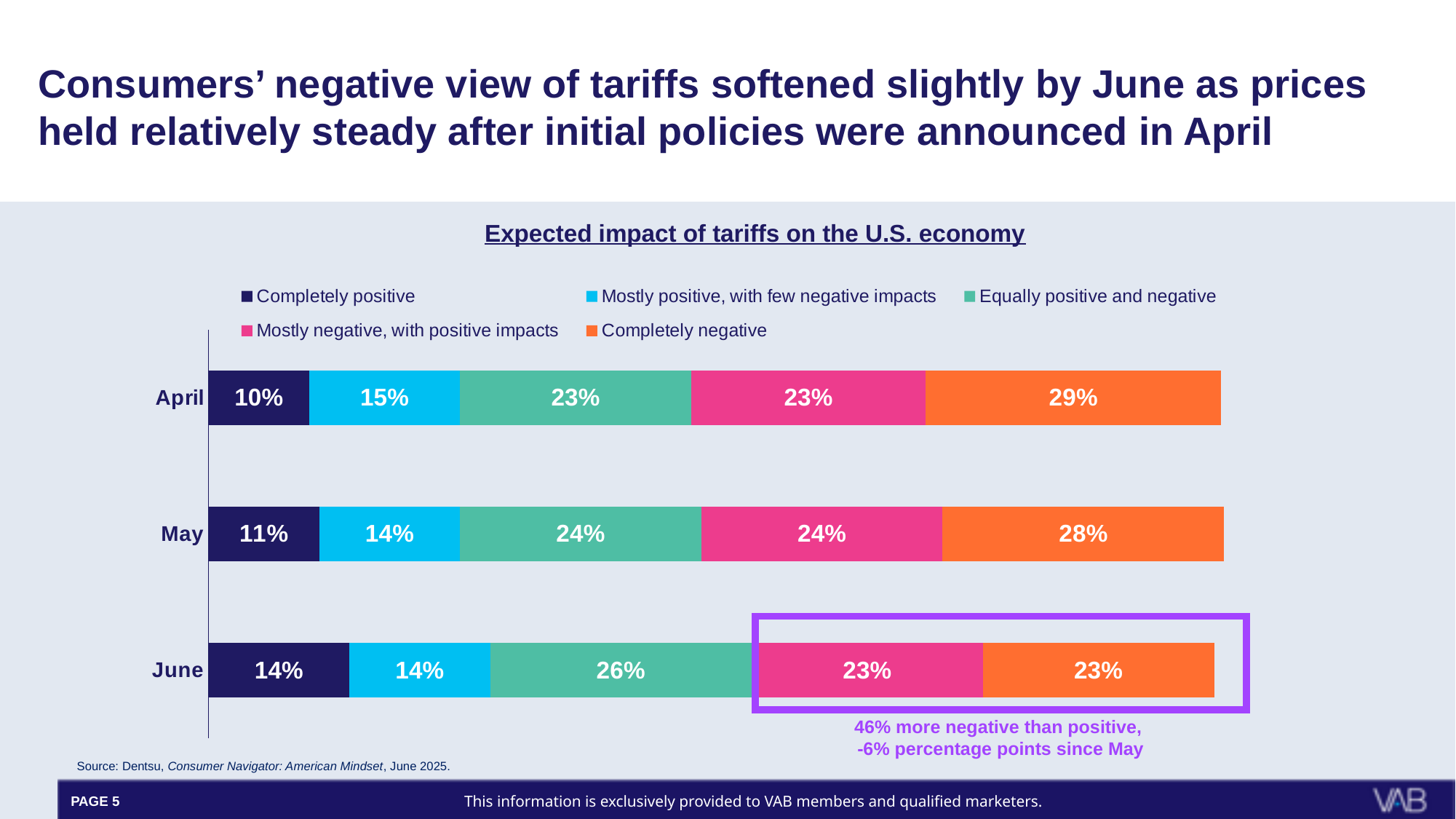
What is the title of the chart? Expected impact of tariffs on the U.S. economy Is the 'Equally positive and negative' value larger in June or in April? June How many series does the legend list? 5 What is the difference between the 'Completely negative' values for May and June? 5% What is the value for 'Completely positive' in June? 14% What is the value for 'Completely negative' in April? 29% Which month has the lowest value for 'Completely positive'? April How many months are shown on the chart? 3 What is the value for 'Equally positive and negative' in May? 24% What kind of chart is shown on the slide? Stacked bar chart Which month has the highest value for 'Completely negative'? April What is the value for 'Mostly positive, with few negative impacts' in April? 15%